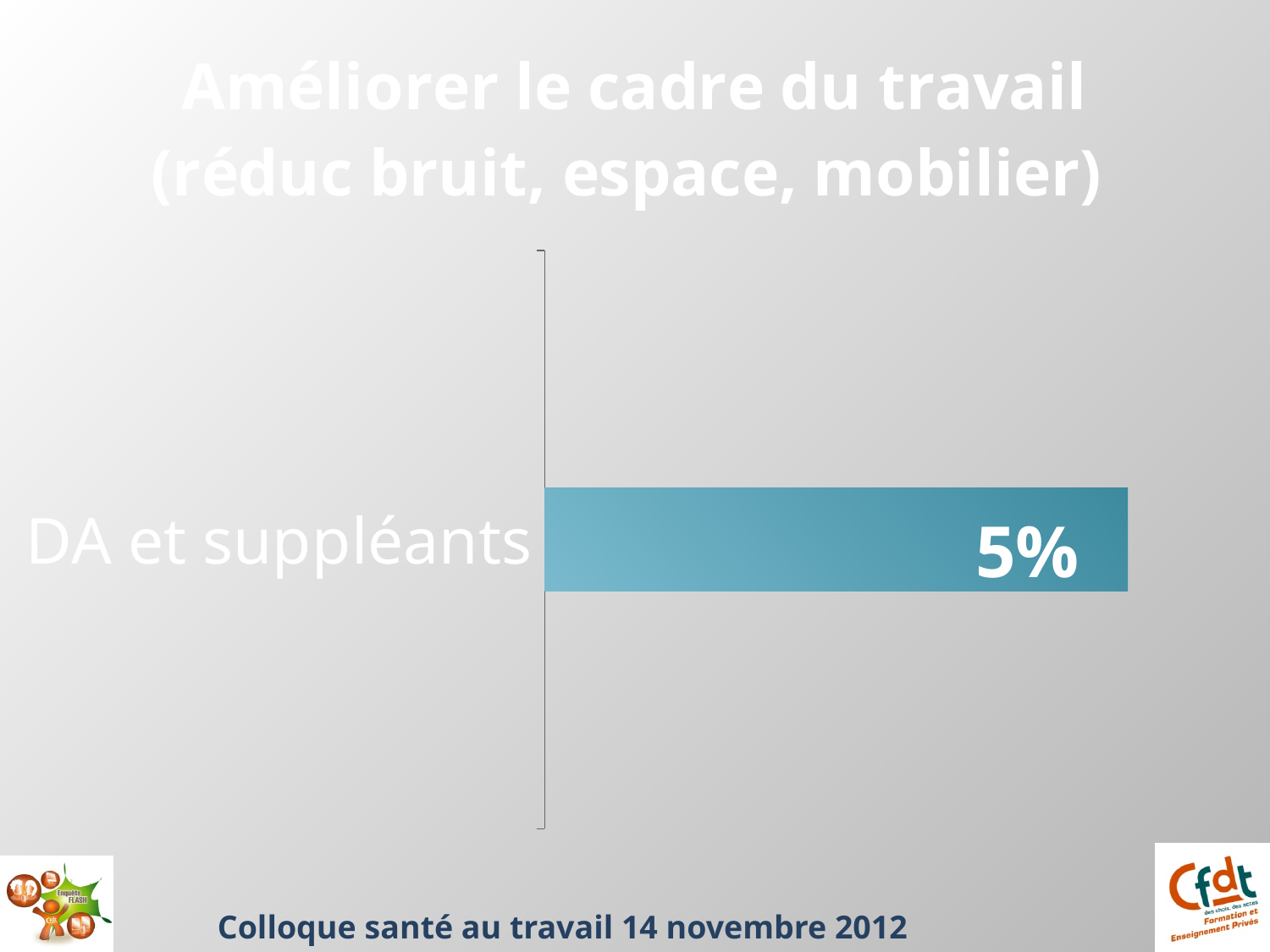
How many categories does the chart show? 1 What is the title of the chart on the slide? Améliorer le cadre du travail (réduc bruit, espace, mobilier) What is the label of the only category in the chart? DA et suppléants What is the value for DA et suppléants? 5% What kind of chart is shown on the slide? bar chart Is the bar in the chart horizontal or vertical? horizontal